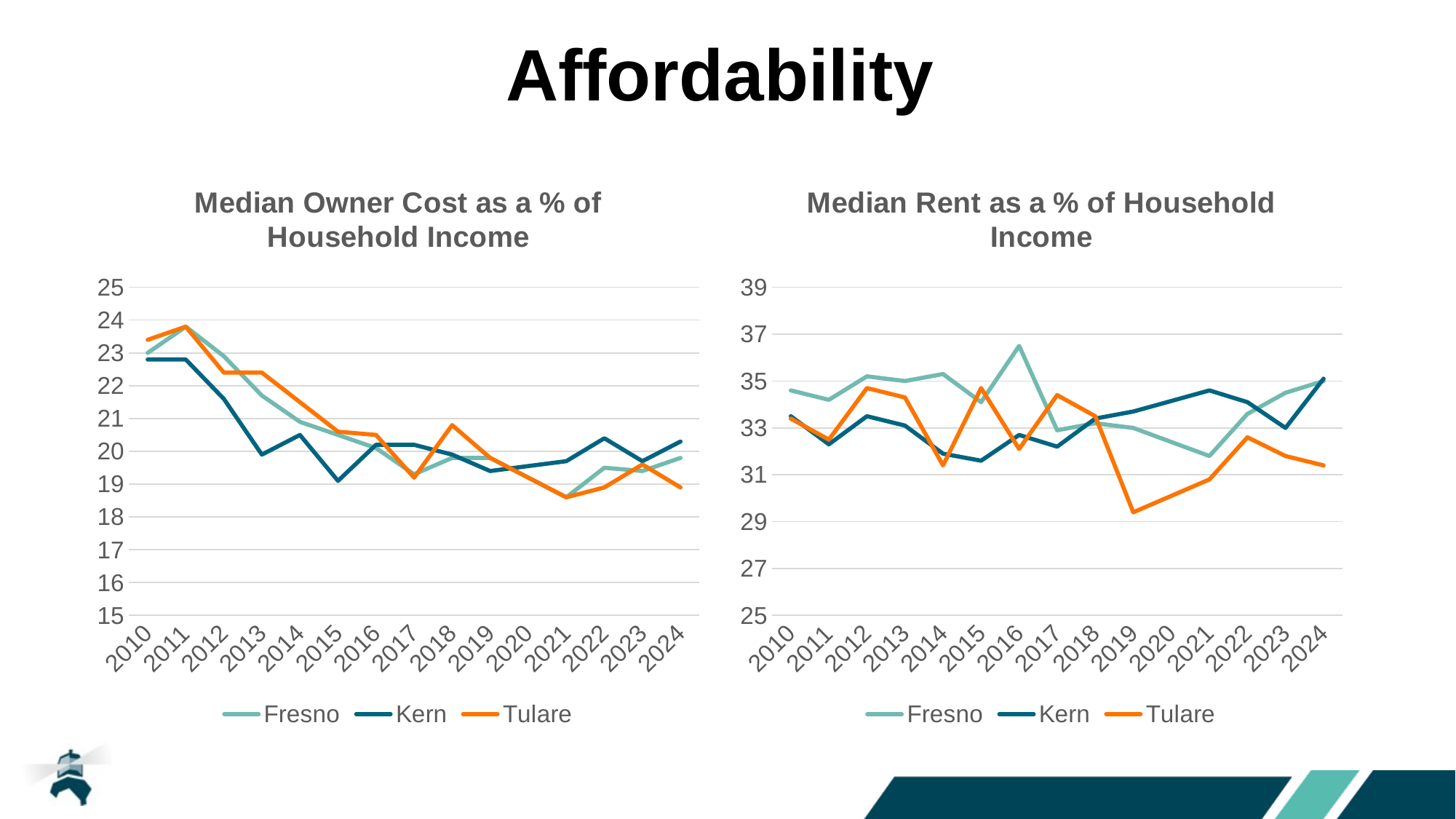
In the "Median Owner Cost as a % of Household Income" chart, which is higher in 2013, Kern or Tulare? Tulare In the "Median Owner Cost as a % of Household Income" chart, is the value for Tulare in 2011 greater or less than 23? greater How many years are plotted along the x axis of the "Median Owner Cost as a % of Household Income" chart? 15 In the "Median Owner Cost as a % of Household Income" chart, is the value for Kern in 2015 greater or less than 20? less In the "Median Rent as a % of Household Income" chart, is the value for Tulare in 2019 greater or less than 31? less What type of chart is the "Median Owner Cost as a % of Household Income" chart? Line chart How many series does the legend of the "Median Rent as a % of Household Income" chart list? 3 In the "Median Rent as a % of Household Income" chart, which series has the highest value in 2016? Fresno Which series is drawn in orange in the legend of the "Median Owner Cost as a % of Household Income" chart? Tulare In the "Median Owner Cost as a % of Household Income" chart, does the Kern line rise or fall from 2011 to 2015? Fall In the "Median Rent as a % of Household Income" chart, which series has the lowest value in 2019? Tulare